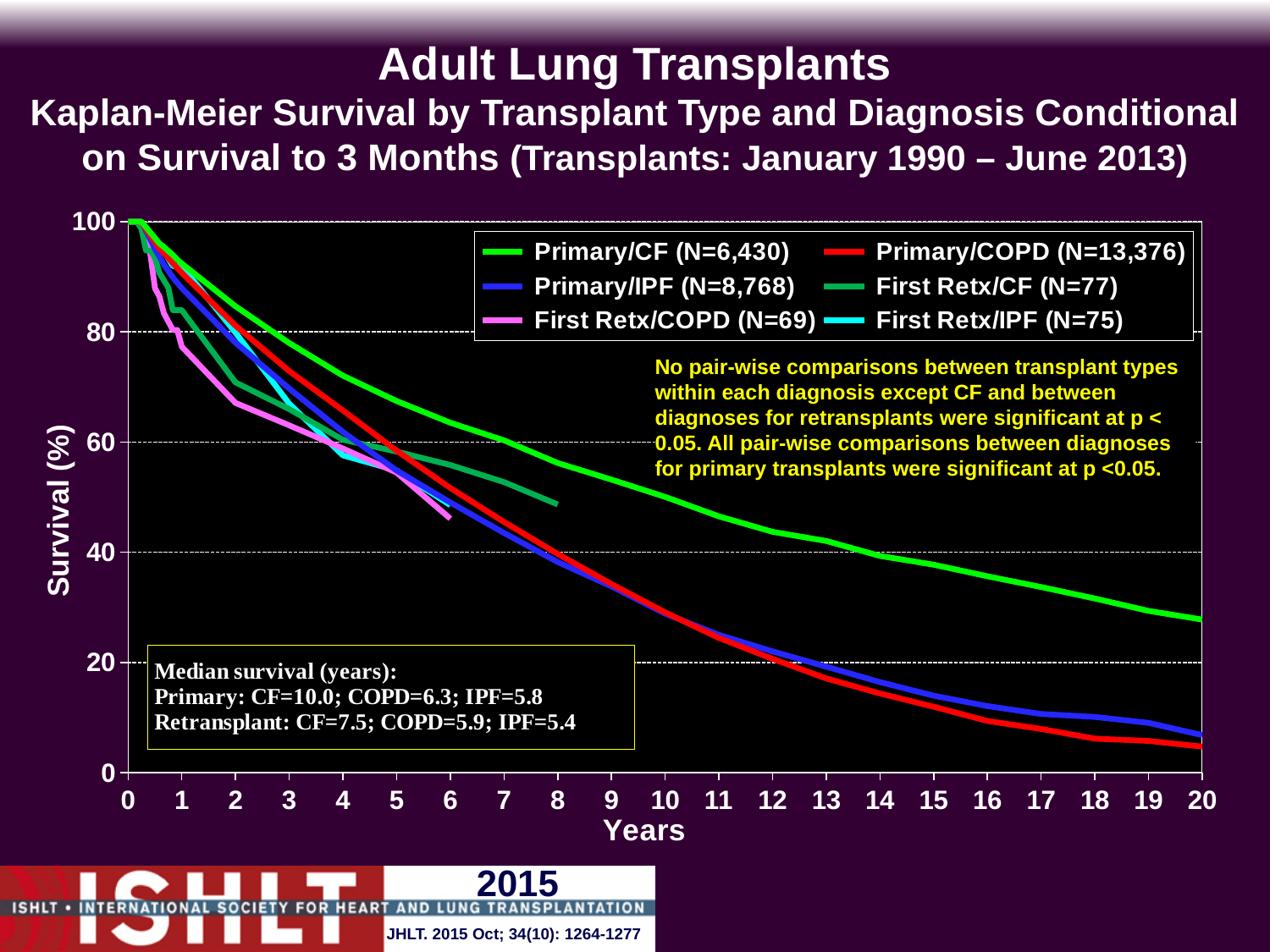
Is the survival for Primary/CF at 10 years greater or less than 40? greater What is the N for the Primary/COPD series in the legend? 13,376 Which series has a larger N, Primary/IPF or Primary/CF? Primary/IPF Is the survival for Primary/COPD at 20 years greater or less than 20? less Which group has the lowest median survival listed in the text box? Retransplant IPF (5.4) What is the median survival in years for Primary CF transplants? 10.0 How many series does the legend list? 6 What kind of chart is shown on the slide? Line chart Which series has the highest survival at 20 years? Primary/CF Do the survival curves rise or fall as years increase along the x axis? Fall What is the median survival in years for Retransplant IPF? 5.4 What is the difference in median survival between Primary CF and Primary IPF? 4.2 years